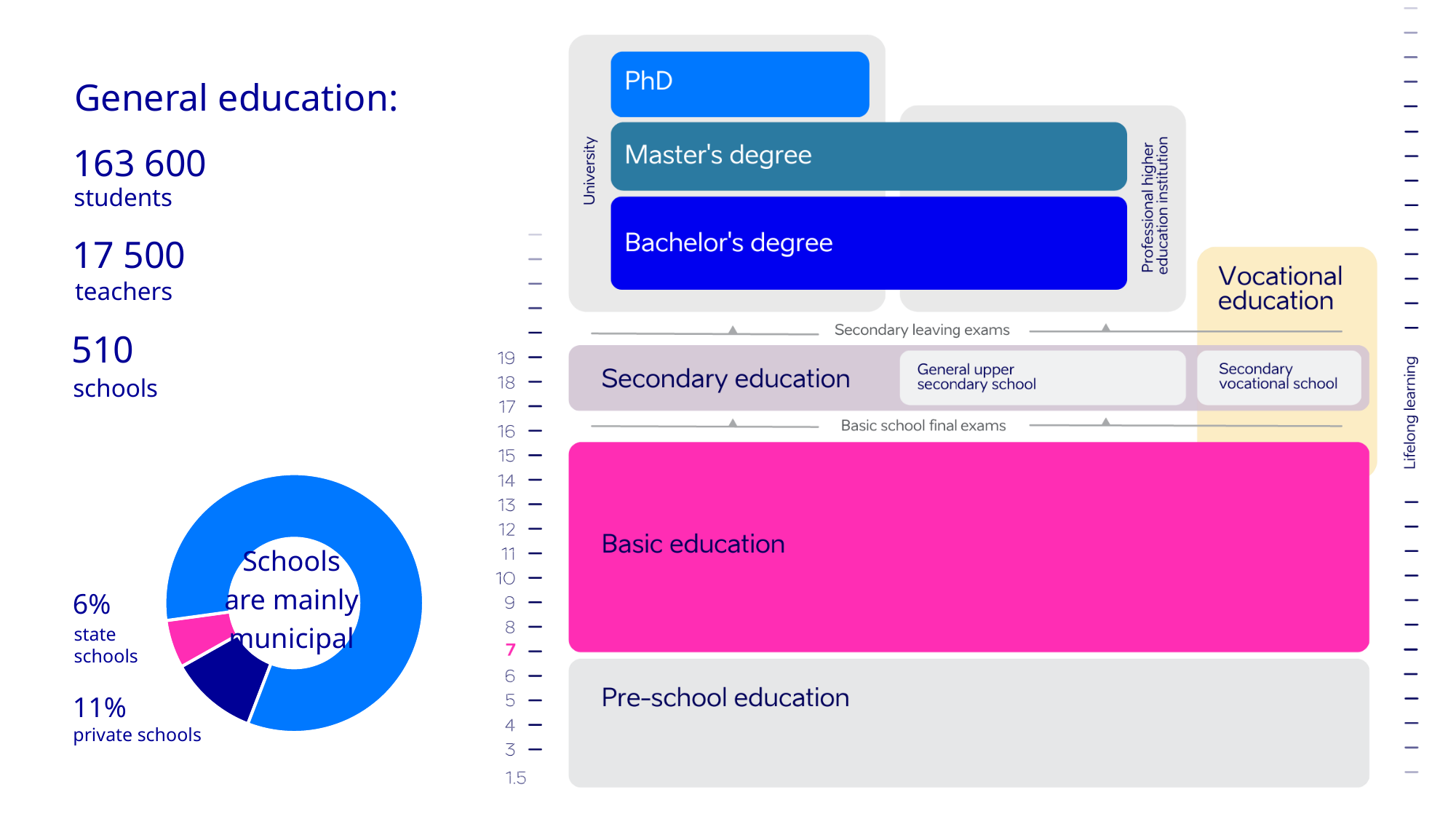
In the donut chart, which category has the smallest slice? state schools In the donut chart, is the share of state schools greater or less than 10%? less In the donut chart, what share of schools are state schools? 6% What text is written in the centre of the donut chart? Schools are mainly municipal What kind of chart is shown on the left of the slide? Donut (pie) chart In the donut chart, what is the difference between the private schools share and the state schools share? 5% In the donut chart, what share of schools are private schools? 11% In the donut chart, what colour is the slice for private schools? dark navy blue How many slices does the donut chart have? 3 In the donut chart, which labelled slice is larger: state schools or private schools? private schools In the donut chart, which category has the largest slice? municipal schools